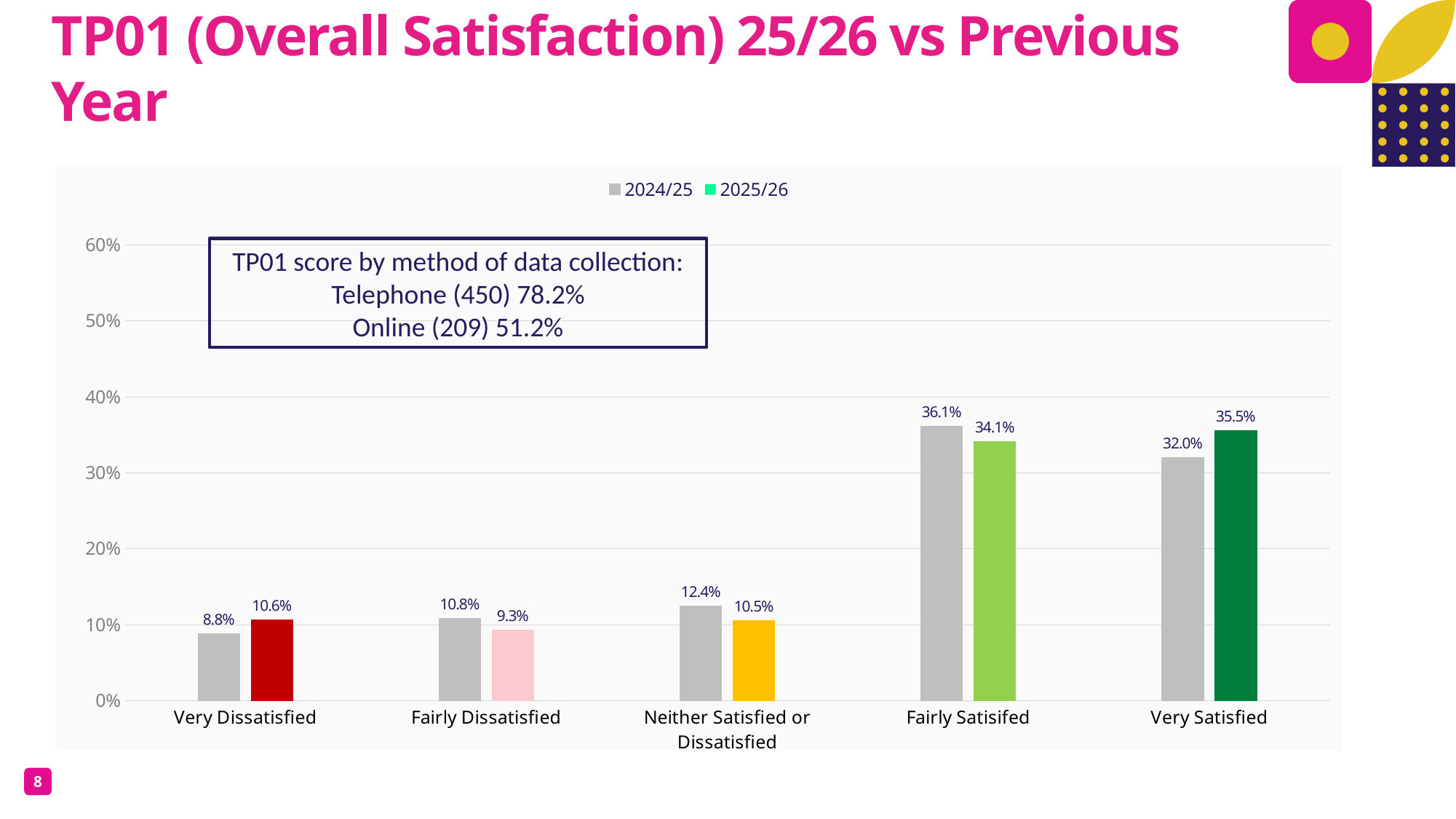
What is the 2024/25 value for Neither Satisfied or Dissatisfied? 12.4% How many categories are shown on the x axis? 5 Which is larger for Fairly Satisifed: the 2024/25 value or the 2025/26 value? 2024/25 What is the difference between the 2024/25 and 2025/26 values for Very Satisfied? 3.5% What is the difference between the 2024/25 and 2025/26 values for Very Dissatisfied? 1.8% Which category has the lowest 2025/26 value? Fairly Dissatisfied What is the 2025/26 value for Very Satisfied? 35.5% What kind of chart is shown on the slide? Bar chart According to the text box on the chart, what is the TP01 score for Telephone? 78.2% What is the 2025/26 value for Fairly Dissatisfied? 9.3% Which category has the highest 2024/25 value? Fairly Satisifed How many series does the legend list? 2